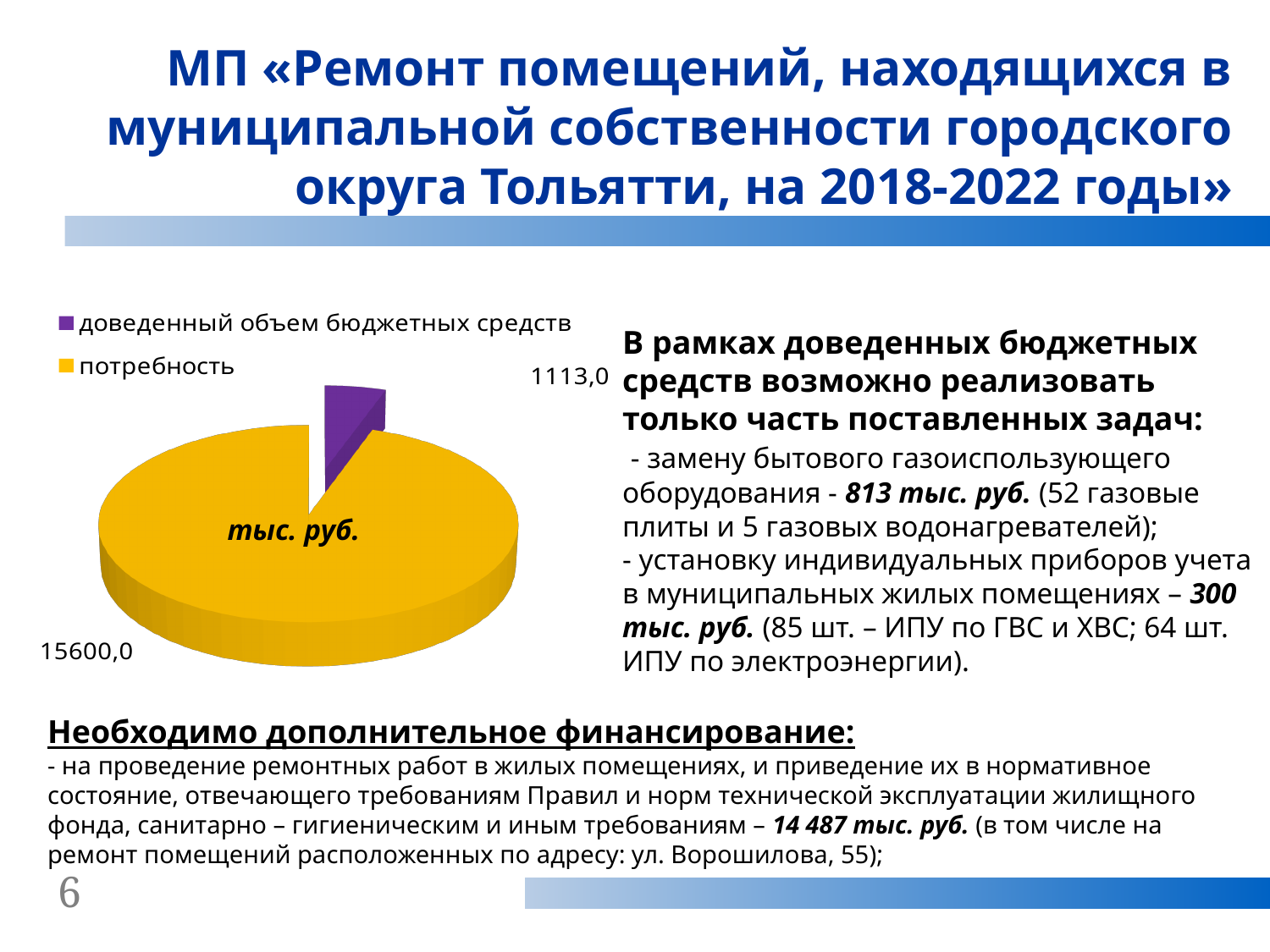
Which category has the largest slice of the pie chart? потребность How many slices does the pie chart have? 2 What kind of chart is shown on the slide? pie chart Which is larger on the pie chart: «потребность» or «доведенный объем бюджетных средств»? потребность What unit label is printed inside the pie chart? тыс. руб. What is the value for «потребность» on the pie chart? 15600,0 How many entries does the legend of the chart list? 2 What colour is the «потребность» slice of the pie chart? yellow Which category has the smallest slice of the pie chart? доведенный объем бюджетных средств What is the value for «доведенный объем бюджетных средств» on the pie chart? 1113,0 What is the difference between «потребность» and «доведенный объем бюджетных средств» on the pie chart? 14487,0